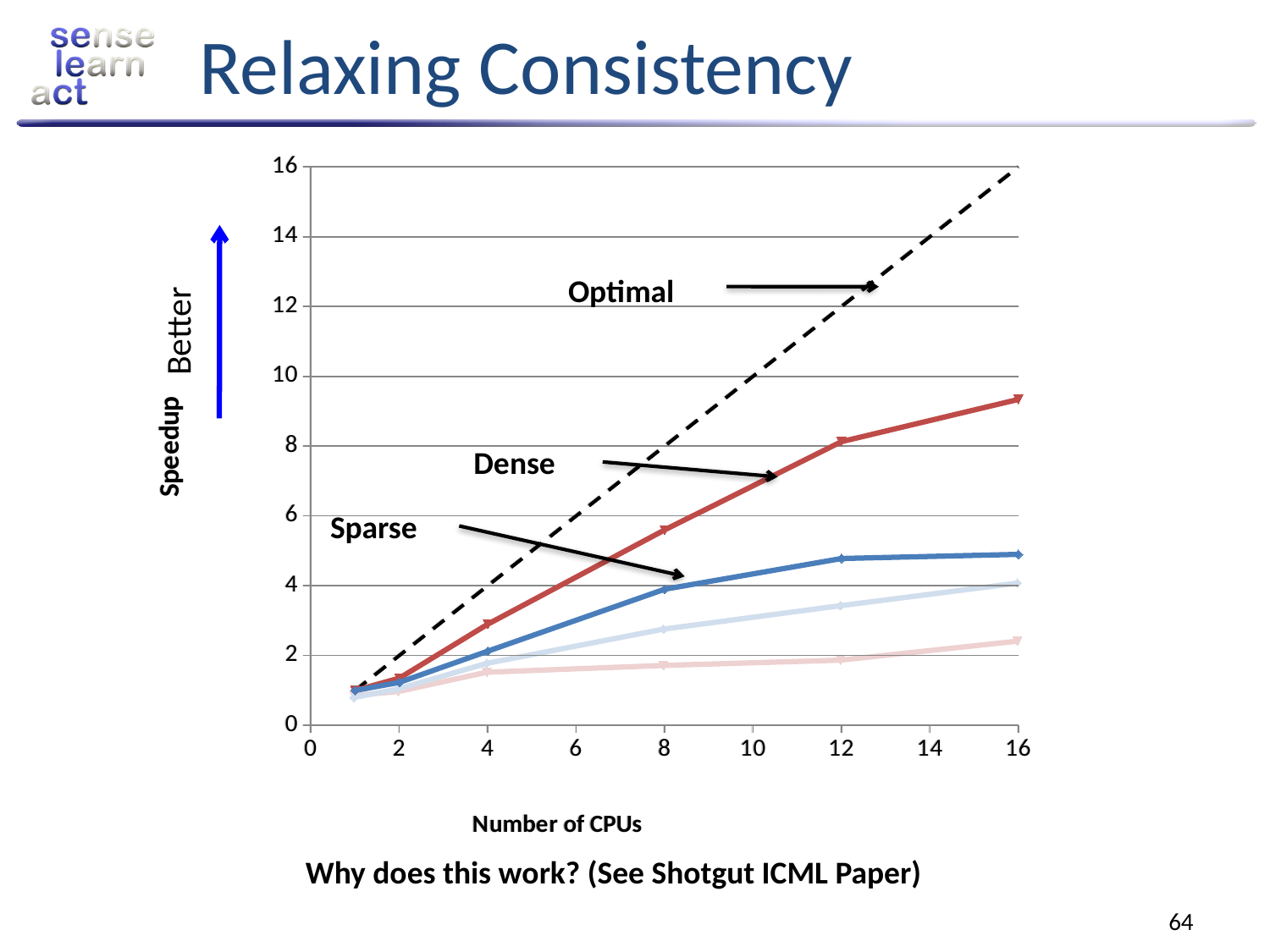
Is the speedup for the Sparse line at 16 CPUs greater or less than 6? less At 16 CPUs, which has the higher speedup, the Dense line or the Sparse line? Dense Is the speedup for the Dense line at 8 CPUs greater or less than 4? greater What is the label of the x axis? Number of CPUs Is the speedup for the Sparse line at 12 CPUs greater or less than 4? greater Which of the labelled lines has the highest speedup at 16 CPUs? Optimal What kind of chart is shown on the slide? line chart Does the speedup for the Dense line rise or fall as the number of CPUs increases? rise What is the label of the y axis? Speedup